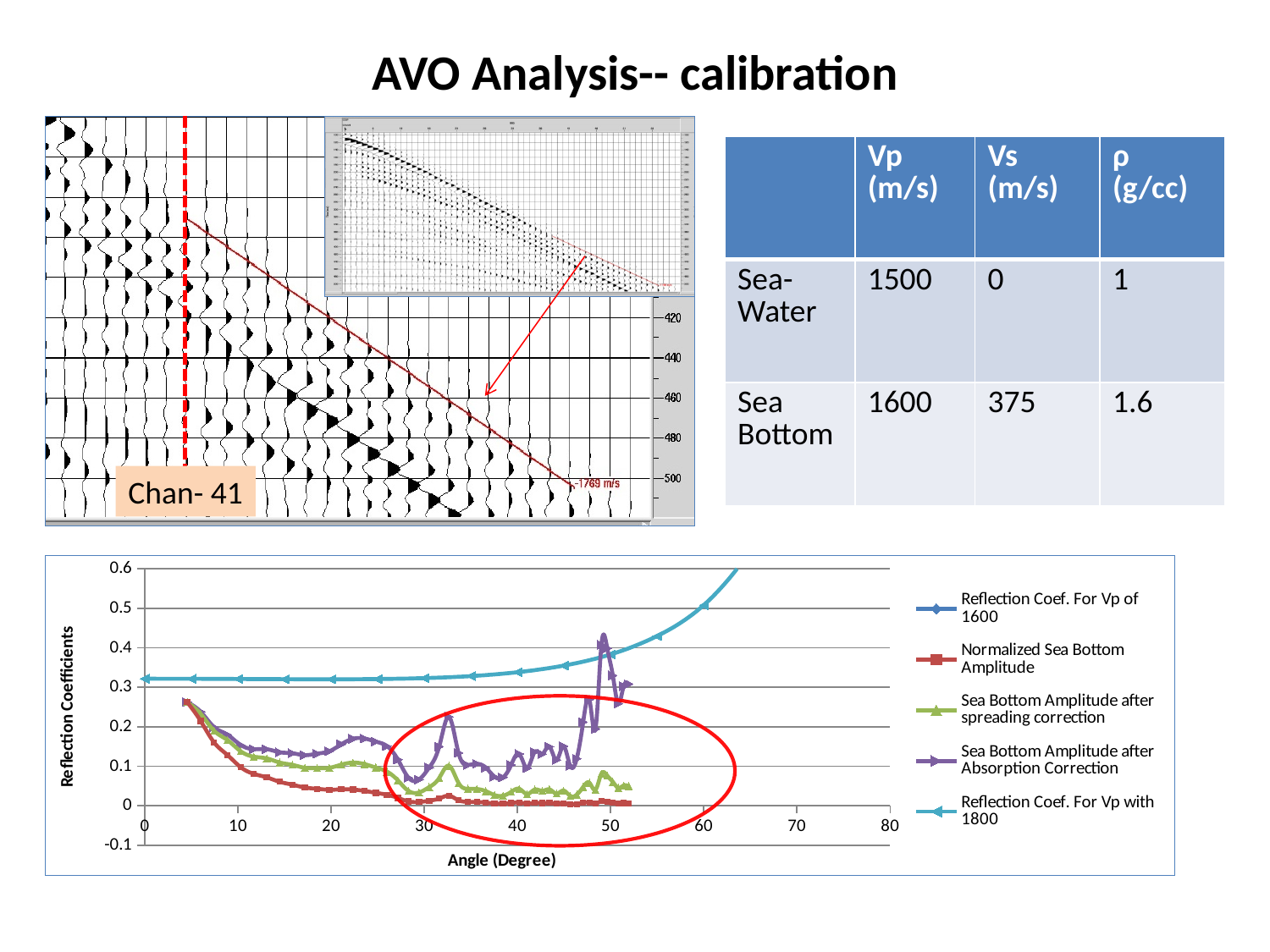
What is the highest value labelled on the y-axis of the bottom chart? 0.6 How many series does the legend of the bottom chart list? 5 What kind of chart is shown at the bottom of the slide? line chart What is the x-axis title of the bottom chart? Angle (Degree) What is the y-axis title of the bottom chart? Reflection Coefficients In the bottom chart, at angle 20, which is larger: 'Sea Bottom Amplitude after Absorption Correction' or 'Normalized Sea Bottom Amplitude'? Sea Bottom Amplitude after Absorption Correction In the bottom chart, is the value of 'Normalized Sea Bottom Amplitude' at angle 40 greater or less than 0.1? less In the bottom chart, is the value of 'Reflection Coef. For Vp with 1800' at angle 10 greater or less than 0.4? less In the bottom chart, is the value of 'Reflection Coef. For Vp with 1800' at angle 60 greater or less than 0.4? greater In the bottom chart, which series reaches the highest value on the chart? Reflection Coef. For Vp with 1800 In the bottom chart, does the 'Normalized Sea Bottom Amplitude' series rise or fall between angle 5 and angle 30? fall In the bottom chart, does the 'Reflection Coef. For Vp with 1800' series rise or fall as the angle increases? rise